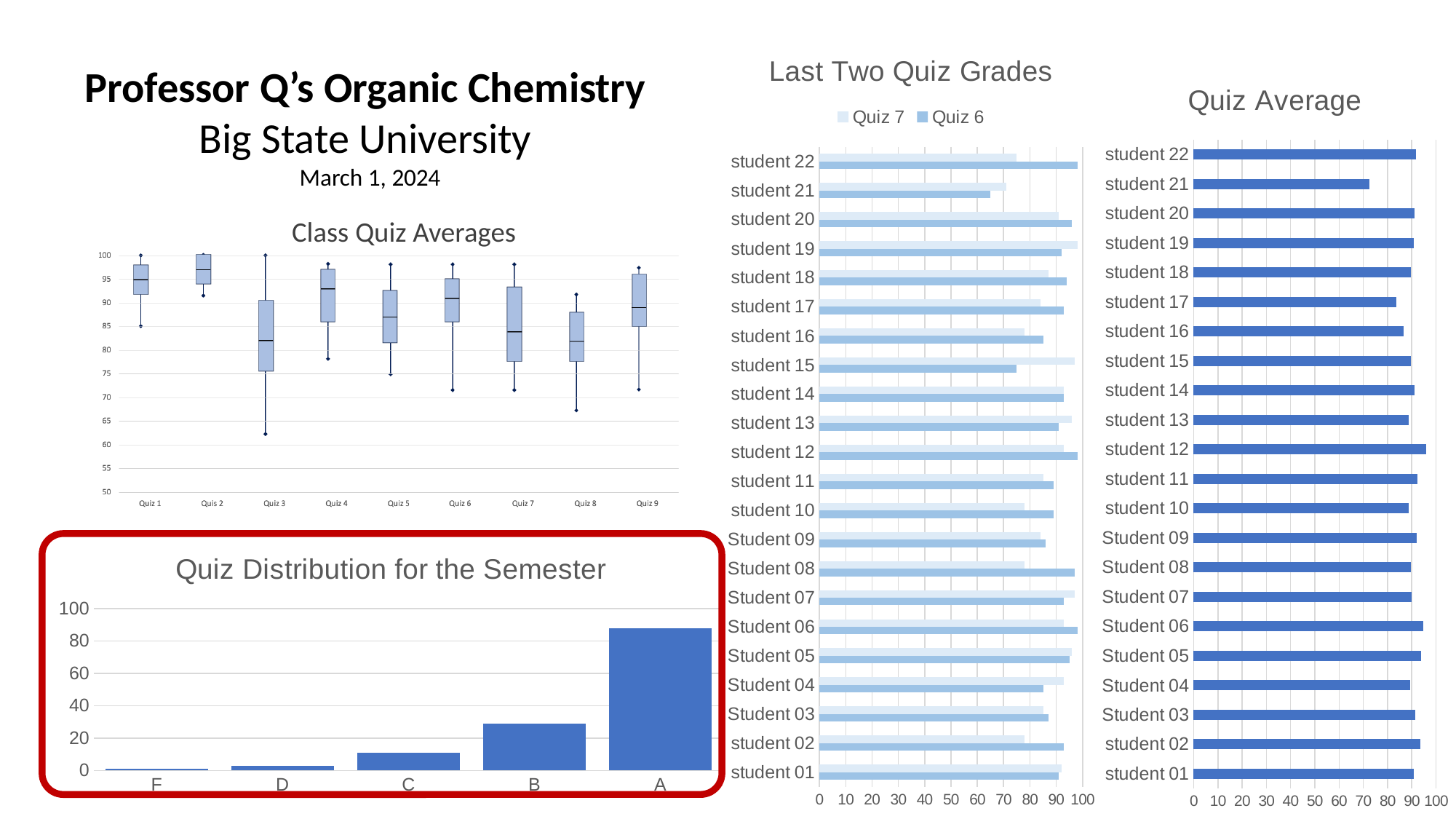
In the Quiz Average chart, which student has the lowest value? student 21 How many series does the legend of the Last Two Quiz Grades chart list? 2 In the Quiz Distribution for the Semester chart, is the value for A greater or less than 80? greater In the Quiz Distribution for the Semester chart, how many grade categories are shown on the x axis? 5 In the Quiz Distribution for the Semester chart, do the values rise or fall moving from F to A along the x axis? rise In the Last Two Quiz Grades chart, is the Quiz 6 value for student 21 greater or less than 70? less What kind of chart is the Quiz Distribution for the Semester chart? bar chart In the Quiz Distribution for the Semester chart, which grade category has the lowest value? F How many quizzes are shown on the x axis of the Class Quiz Averages chart? 9 In the Quiz Distribution for the Semester chart, which grade category has the highest value? A In the Last Two Quiz Grades chart, which is larger for student 22: the Quiz 7 value or the Quiz 6 value? Quiz 6 In the Quiz Distribution for the Semester chart, is the value for B greater or less than 40? less